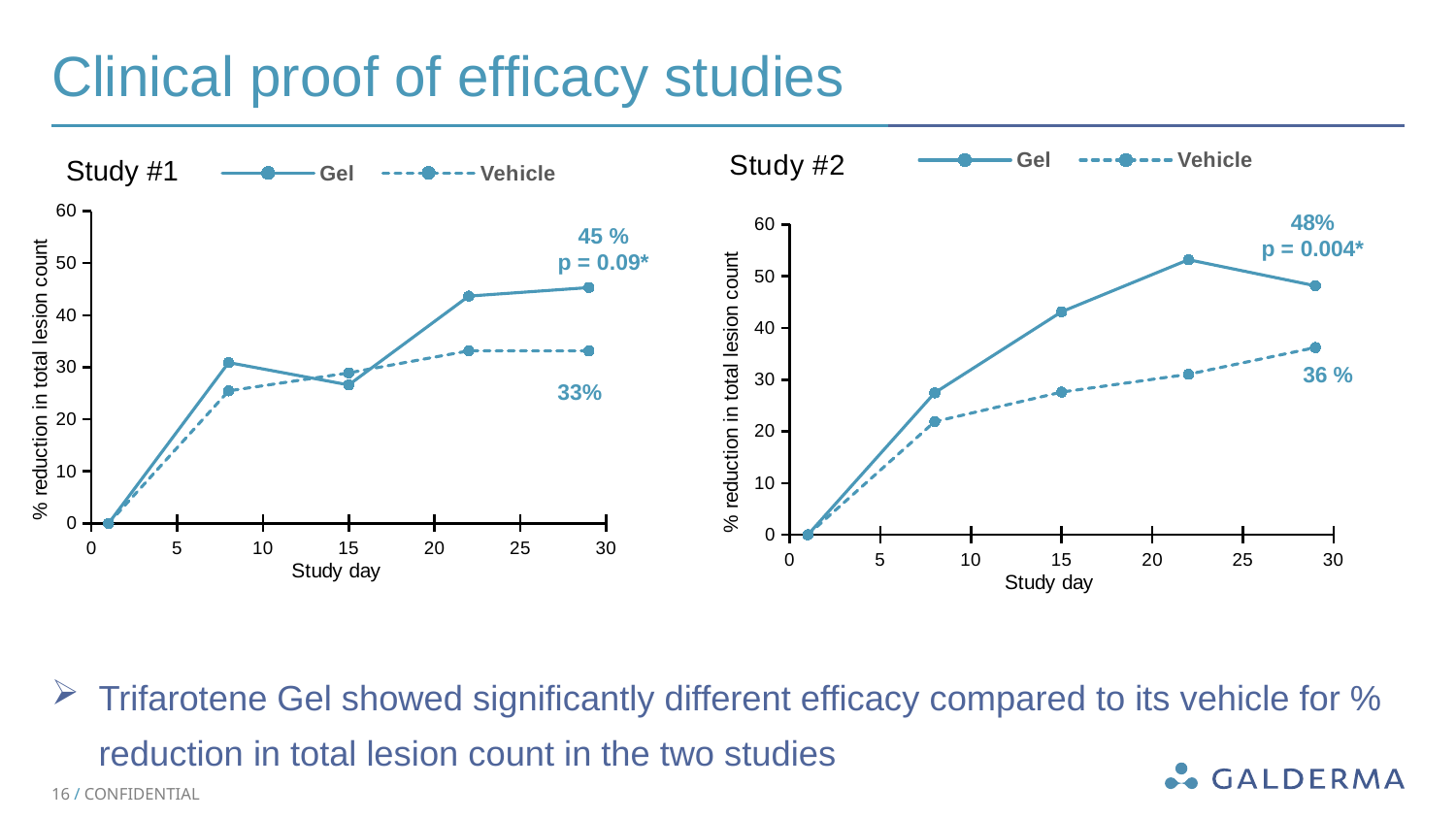
In the Study #2 chart, what is the labelled % reduction in total lesion count for Gel at the final study day? 48% What p-value is printed on the Study #2 chart? p = 0.004* In the Study #2 chart, how many data points are plotted for the Gel series? 5 In the Study #2 chart, what is the labelled % reduction in total lesion count for Vehicle at the final study day? 36 % In the Study #1 chart, what is the labelled % reduction in total lesion count for Gel at the final study day? 45 % How many series does the legend of the Study #1 chart list? 2 In the Study #1 chart, what is the labelled % reduction in total lesion count for Vehicle at the final study day? 33% In the Study #2 chart, which series has the larger labelled final value, Gel or Vehicle? Gel In the Study #2 chart, at which study day does the Gel series reach its highest value? 22 What kind of chart is the Study #2 chart? Line chart In the Study #1 chart, what is the difference between the labelled final values for Gel and Vehicle? 12 In the Study #2 chart, is the Gel value at study day 22 greater or less than 50? greater